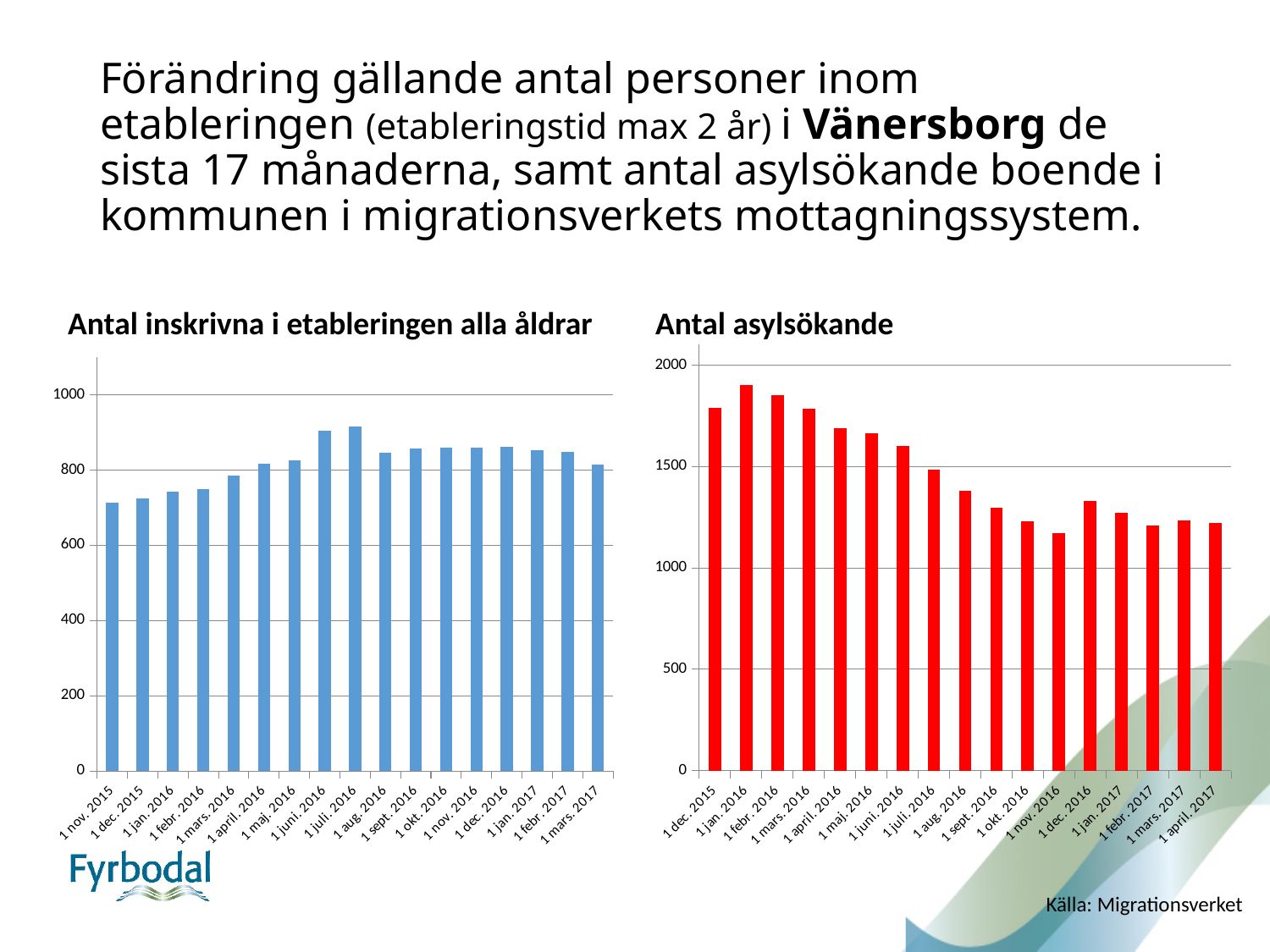
What colour are the bars in the 'Antal asylsökande' chart? red In the 'Antal asylsökande' chart, which is larger: the value for 1 dec. 2015 or the value for 1 april. 2017? 1 dec. 2015 In the 'Antal inskrivna i etableringen alla åldrar' chart, which is larger: the value for 1 juli. 2016 or the value for 1 nov. 2015? 1 juli. 2016 In the 'Antal inskrivna i etableringen alla åldrar' chart, is the value for 1 juli. 2016 greater or less than 800? greater In the 'Antal inskrivna i etableringen alla åldrar' chart, is the value for 1 nov. 2015 greater or less than 800? less How many bars (months) are shown in the 'Antal asylsökande' chart? 17 In the 'Antal asylsökande' chart, is the value for 1 april. 2017 greater or less than 1500? less In the 'Antal asylsökande' chart, do the values generally rise or fall from 1 jan. 2016 to 1 nov. 2016? fall In the 'Antal asylsökande' chart, which month has the highest value? 1 jan. 2016 How many bars (months) are shown in the 'Antal inskrivna i etableringen alla åldrar' chart? 17 What kind of chart is the 'Antal asylsökande' chart? bar chart